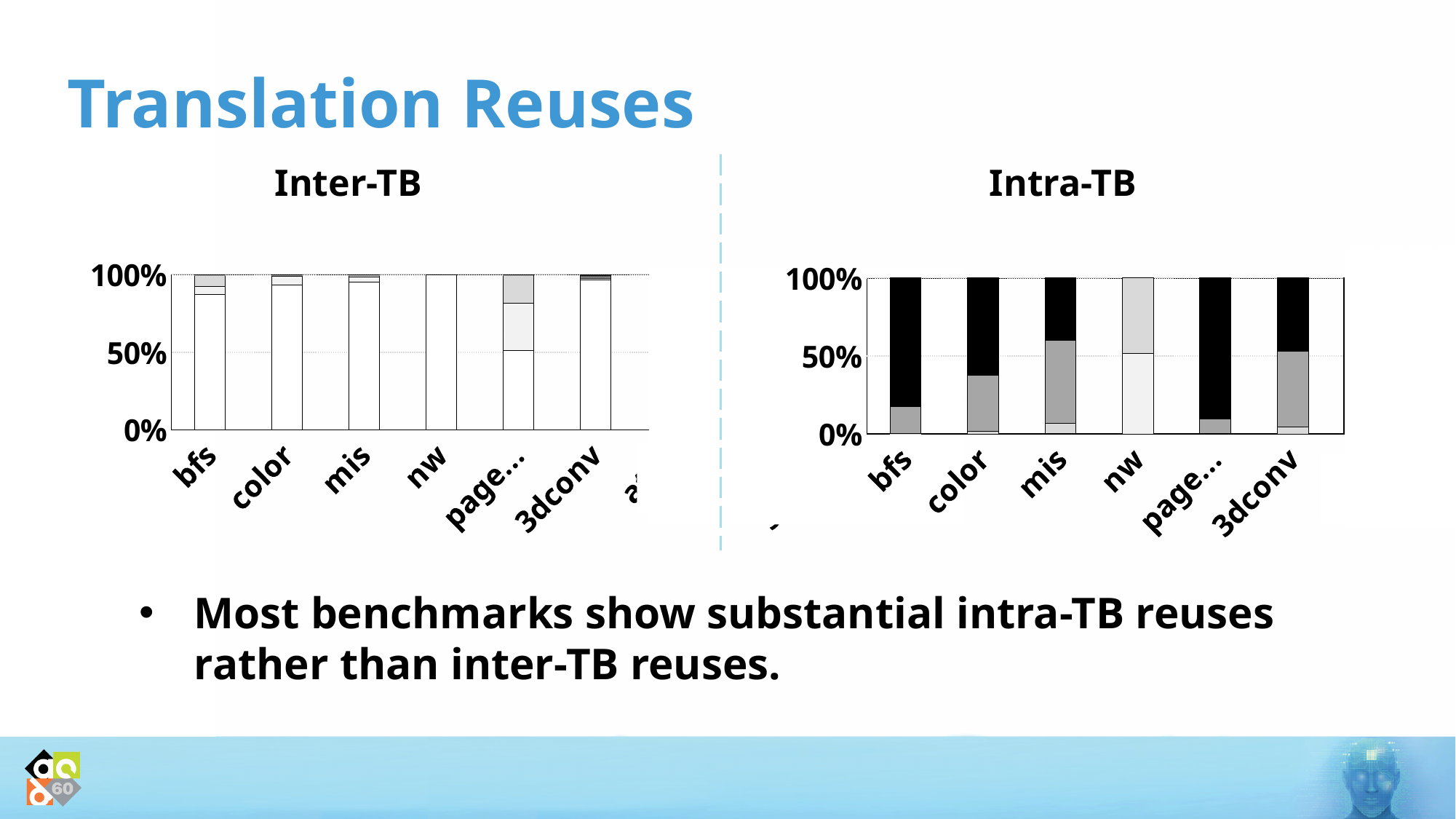
In the Inter-TB chart, which has the larger light grey top segment, page... or bfs? page... In the Intra-TB chart, which has the larger bottom grey segment, bfs or mis? mis In the Intra-TB chart, is the bottom grey segment of the bfs bar greater or less than 50%? less What kind of chart is the Inter-TB chart? stacked bar chart What are the titles of the two charts on the slide? Inter-TB and Intra-TB How many bars are shown in the Intra-TB chart? 6 In the Inter-TB chart, is the bottom white segment of the 3dconv bar greater or less than 50%? greater In the Intra-TB chart, which has the larger black segment, page... or mis? page... What kind of chart is the Intra-TB chart? stacked bar chart In the Inter-TB chart, is the bottom white segment of the bfs bar greater or less than 50%? greater What is the highest tick label on the y axis of the Intra-TB chart? 100%